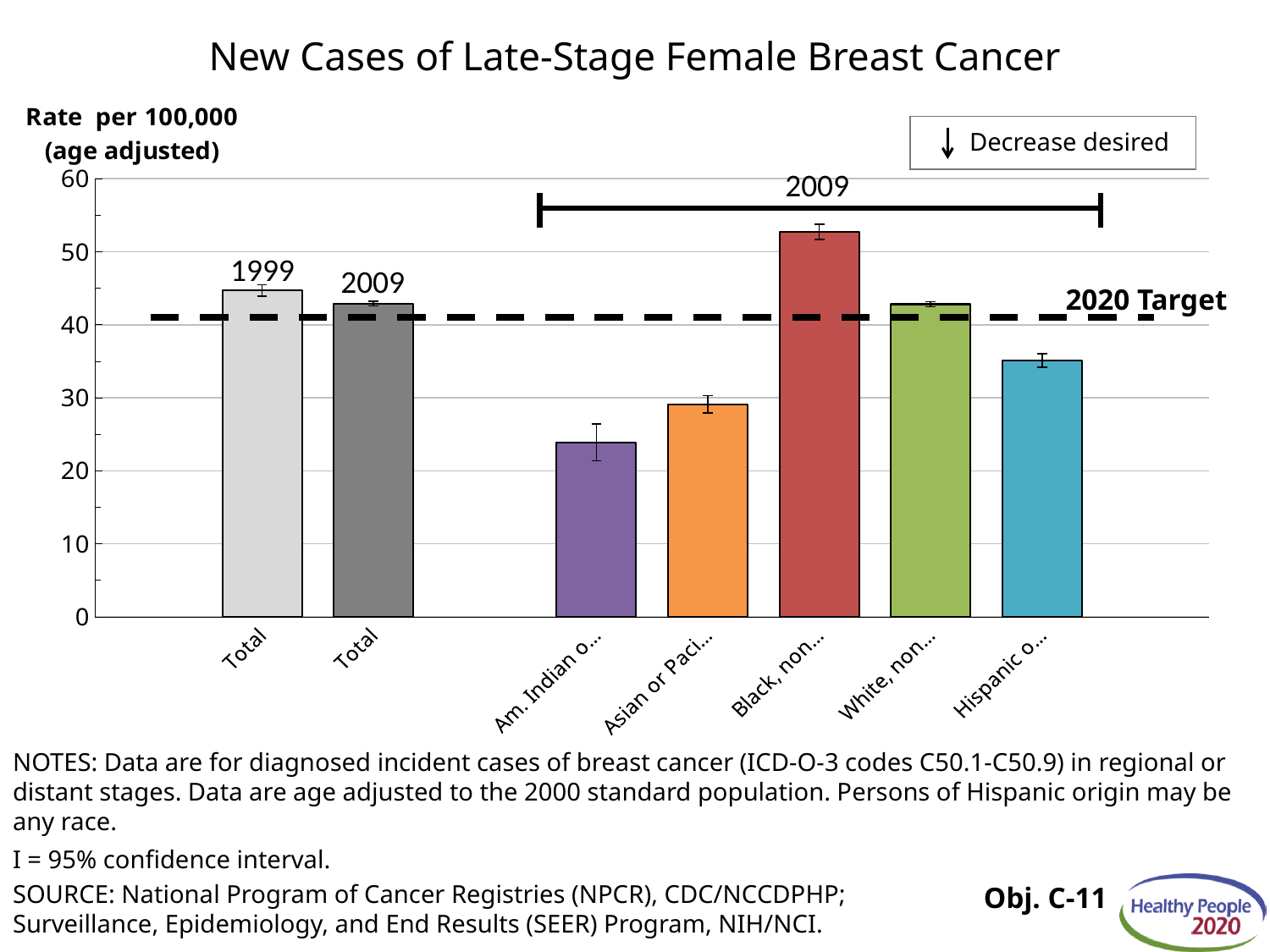
Which is larger, the 2009 value for Black, non... or the 2009 value for White, non...? Black, non... Is the 2009 value for Am. Indian o... greater or less than 30? less What is the title of the chart? New Cases of Late-Stage Female Breast Cancer Is the 2009 value for Black, non... greater or less than 50? greater What kind of chart is shown on the slide? Bar chart What does the horizontal dashed line on the chart represent? 2020 Target How many bars are plotted in the chart? 7 Is the 1999 Total value greater or less than 40? greater Which category has the lowest rate in the chart? Am. Indian o... (2009) Did the Total rate rise or fall from 1999 to 2009? Fall Which category has the highest rate in the chart? Black, non... (2009)